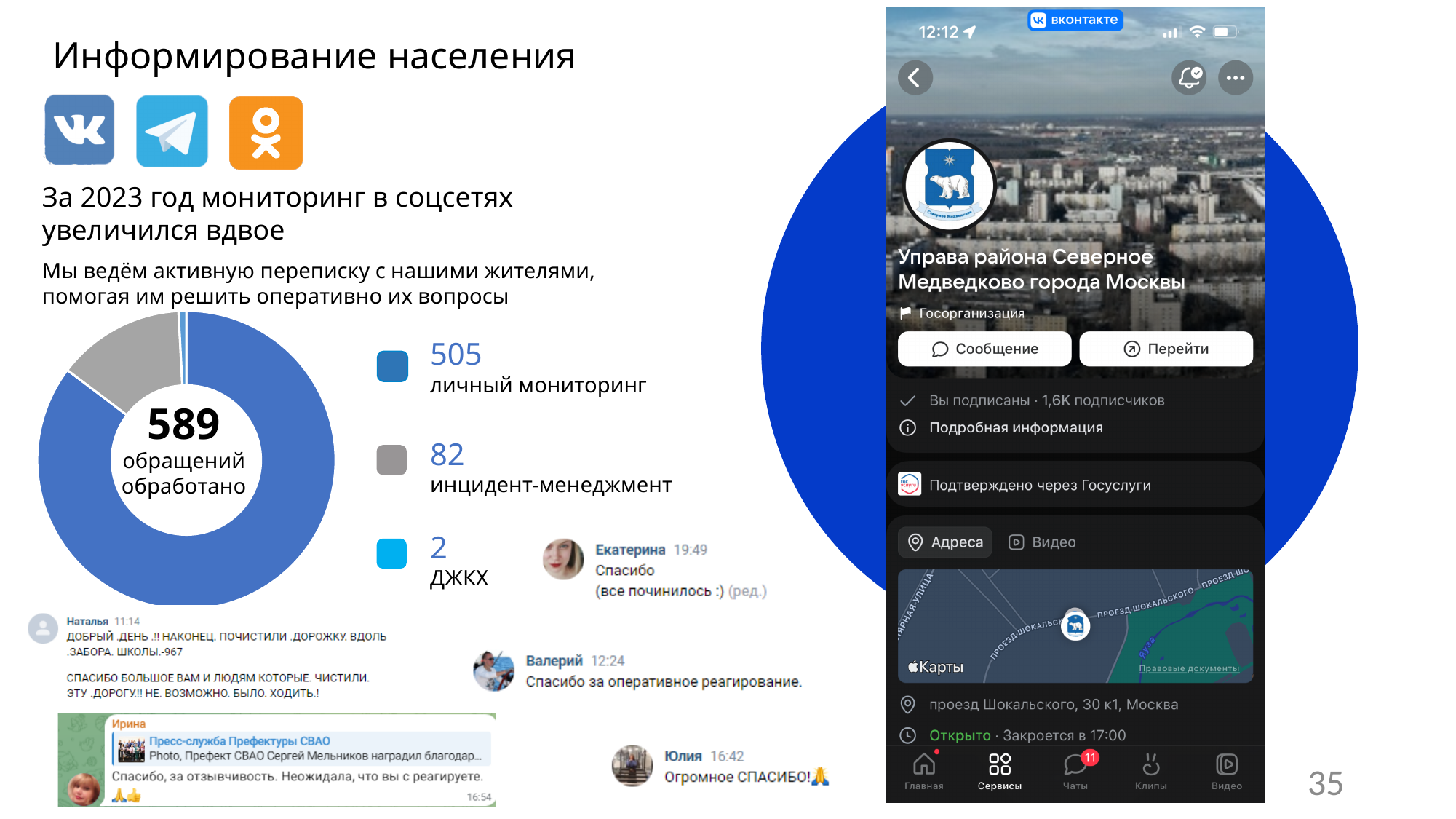
Which category has the highest value in the donut chart? личный мониторинг What is the value for "инцидент-менеджмент" in the donut chart? 82 Which is larger, "инцидент-менеджмент" or "ДЖКХ"? инцидент-менеджмент What is the value for "ДЖКХ" in the donut chart? 2 How many categories does the donut chart show? 3 What colour represents "инцидент-менеджмент" in the donut chart? Gray What colour represents "личный мониторинг" in the donut chart? Blue What is the value for "личный мониторинг" in the donut chart? 505 What total number of processed requests is shown in the centre of the donut chart? 589 Which category has the lowest value in the donut chart? ДЖКХ What is the difference between "личный мониторинг" and "инцидент-менеджмент"? 423 What kind of chart is shown on the slide? Donut (pie) chart